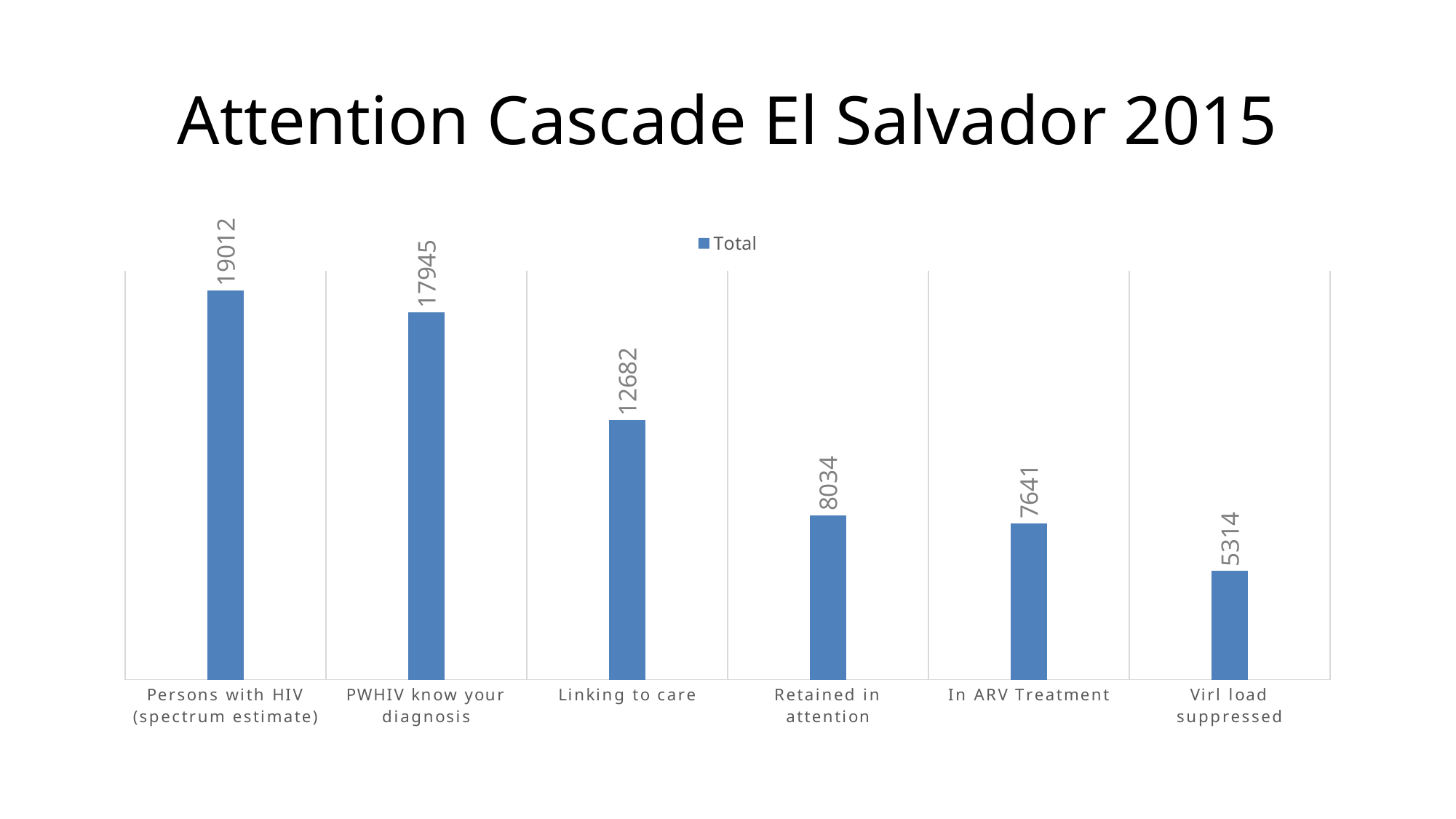
Which is larger, Linking to care or Retained in attention? Linking to care Which category has the lowest value? Virl load suppressed What is the difference between Retained in attention and In ARV Treatment? 393 How many categories are shown on the chart? 6 What is the value for In ARV Treatment? 7641 What is the value for Linking to care? 12682 What is the value for Virl load suppressed? 5314 How many series does the legend list? 1 What kind of chart is shown? Bar chart Do the values rise or fall from left to right along the x axis? Fall Which category has the highest value? Persons with HIV (spectrum estimate) What is the difference between Persons with HIV (spectrum estimate) and PWHIV know your diagnosis? 1067